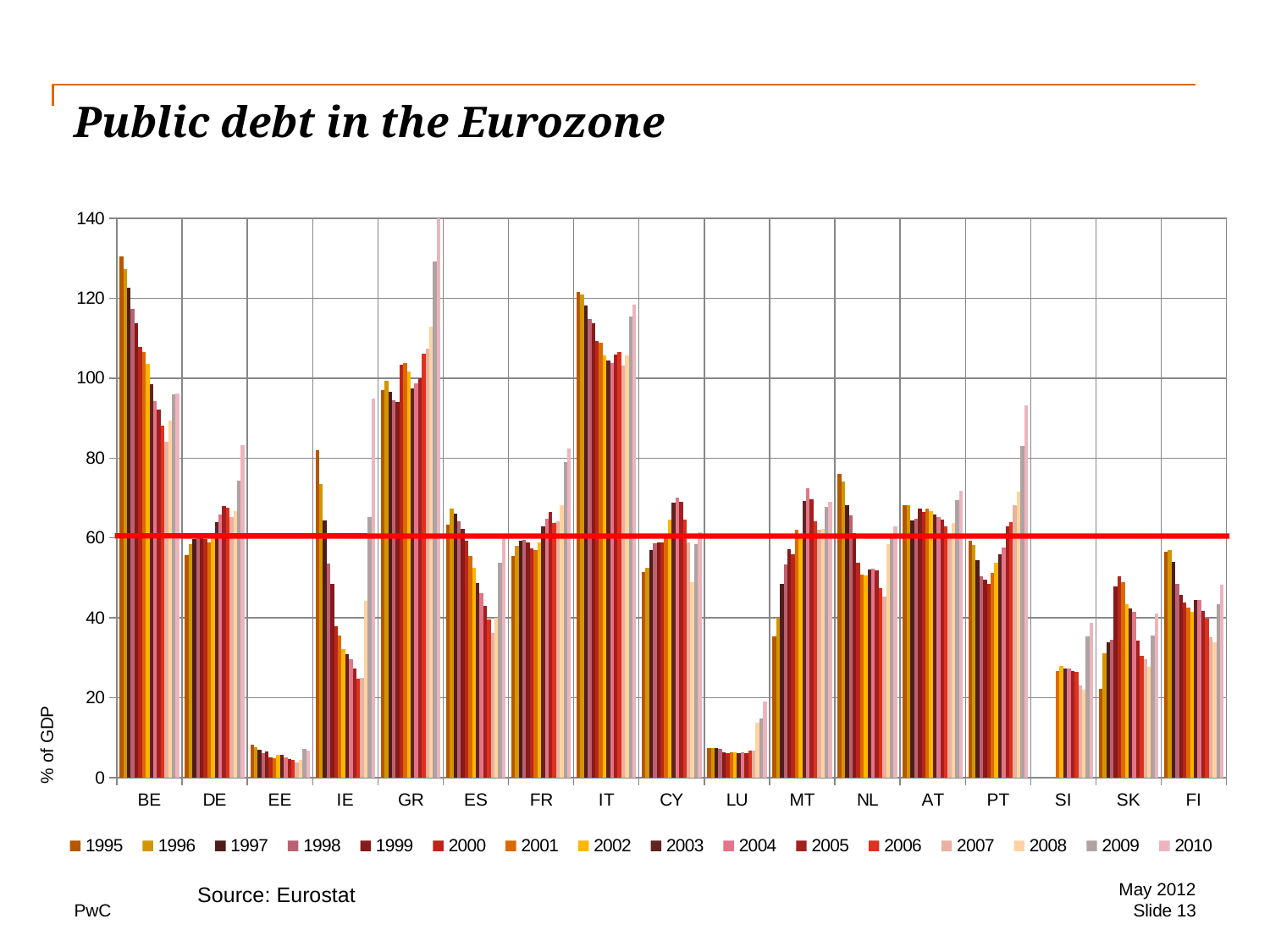
Which country has the tallest bar in the chart? GR Is the value for BE in 1995 greater or less than 120? greater How many series (years) does the legend list? 16 For IE, do the values generally rise or fall from 1995 to 2007? fall What kind of chart is shown on the slide? bar chart Is the value for PT in 2010 greater or less than 80? greater Which is larger, the 2010 value for GR or the 2010 value for IT? GR How many countries are shown along the x axis of the chart? 17 Which country has the lowest public debt values across all years? EE What is the label on the y axis of the chart? % of GDP Is the value for SK in 2010 greater or less than 60? less